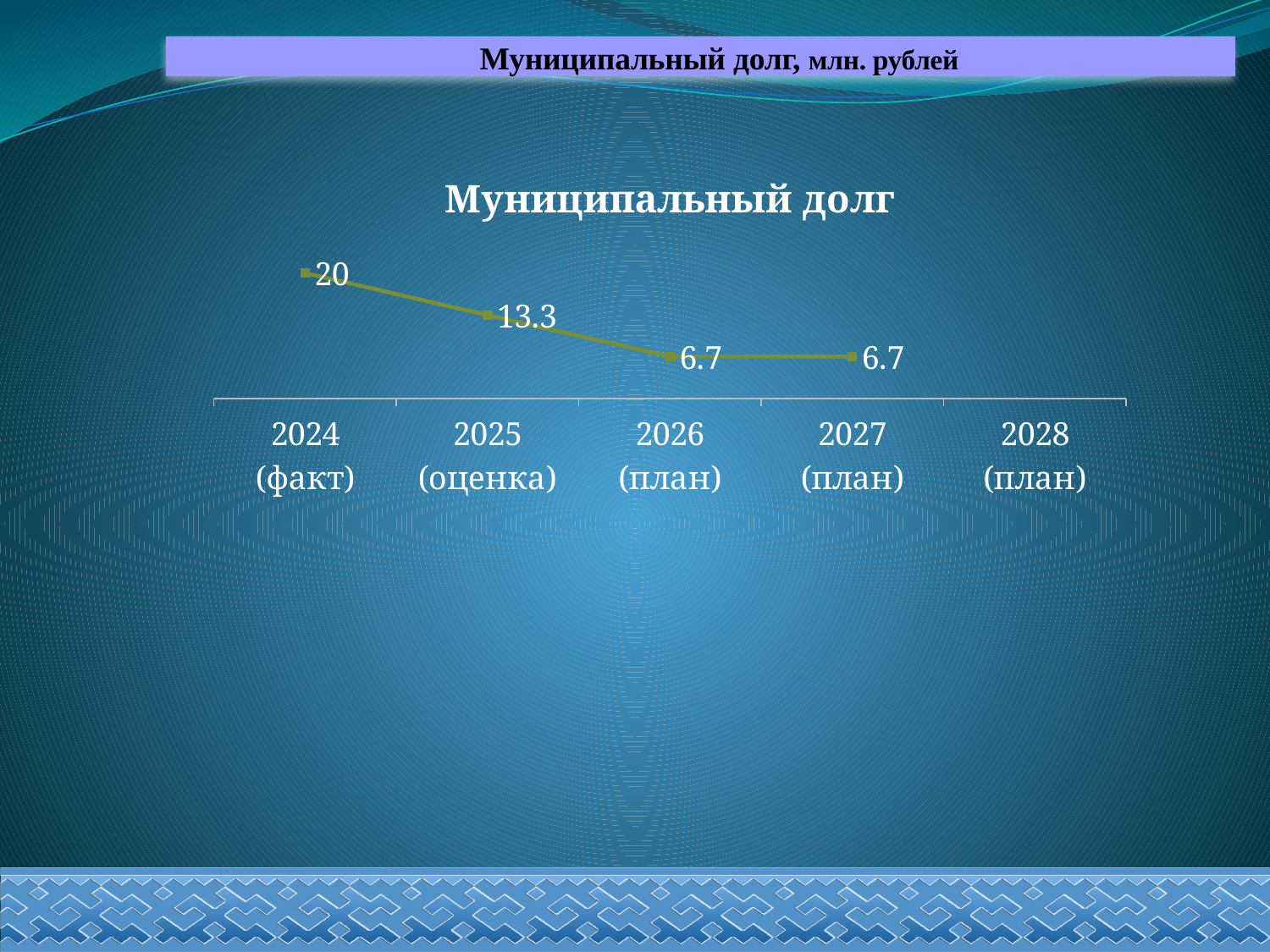
What is the difference between the values for 2025 (оценка) and 2026 (план)? 6.6 What is the value for 2024 (факт)? 20 Do the values rise or fall from 2024 (факт) to 2026 (план)? fall How many data points are plotted on the line? 4 What kind of chart is shown? line chart What is the difference between the values for 2024 (факт) and 2025 (оценка)? 6.7 Which is larger, the value for 2024 (факт) or the value for 2026 (план)? 2024 (факт) What is the value for 2026 (план)? 6.7 What is the value for 2027 (план)? 6.7 Which year has the highest municipal debt? 2024 (факт) What is the value for 2025 (оценка)? 13.3 How many category labels are shown on the x axis? 5